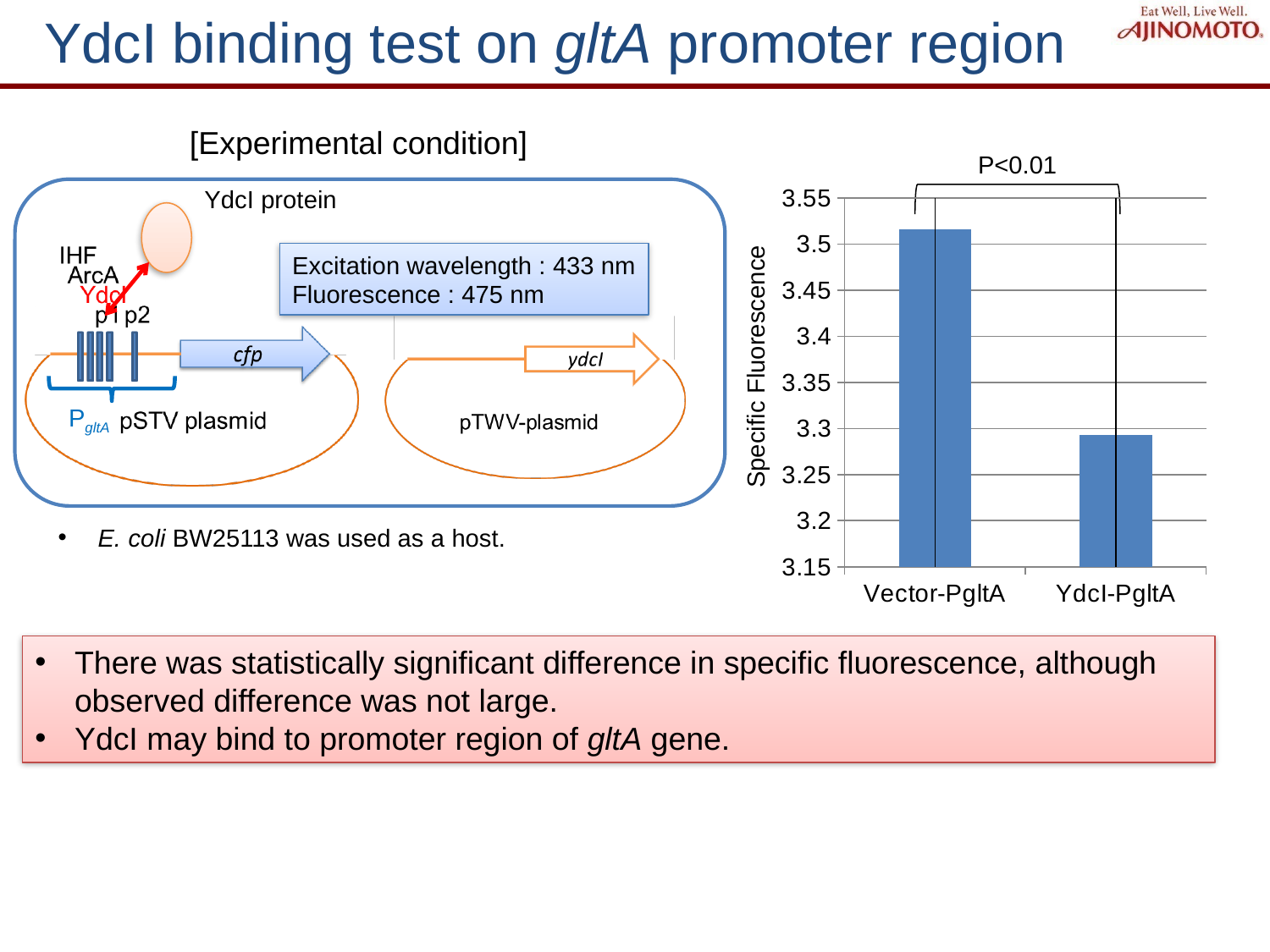
Is the value for Vector-PgltA greater or less than 3.55? less Is the value for YdcI-PgltA greater or less than 3.35? less What kind of chart is shown on the slide? bar chart How many categories are plotted on the x axis of the chart? 2 Which is larger, the specific fluorescence for Vector-PgltA or for YdcI-PgltA? Vector-PgltA Is the value for Vector-PgltA greater or less than 3.45? greater What statistical significance annotation is shown above the bars in the chart? P<0.01 What is the label of the y axis of the chart? Specific Fluorescence Which category has the lowest specific fluorescence in the chart? YdcI-PgltA Which category has the highest specific fluorescence in the chart? Vector-PgltA